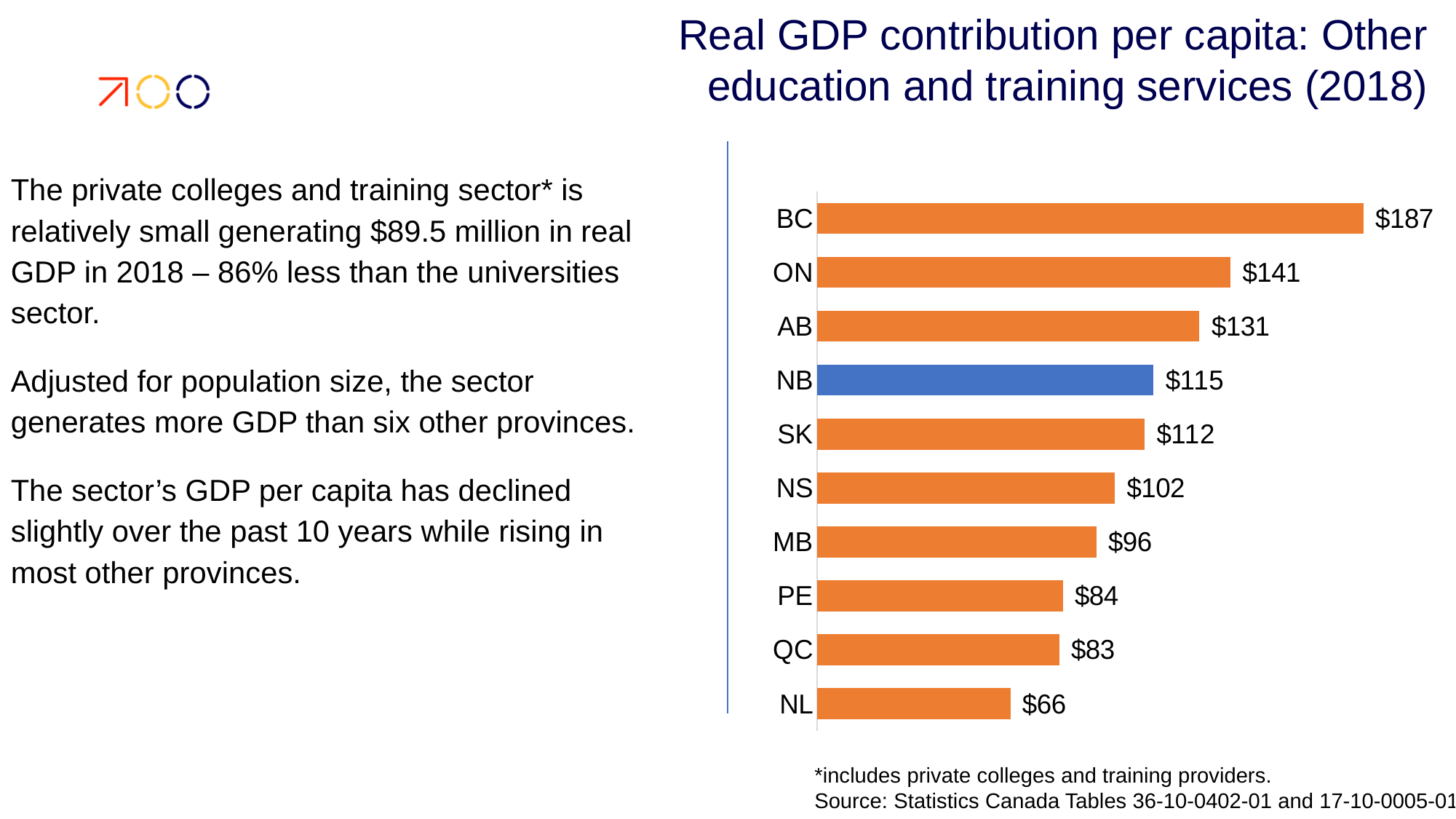
What is the difference between the values for NB and NL? $49 What is the difference between the values for BC and ON? $46 What is the real GDP contribution per capita for NB? $115 What kind of chart is shown on the slide? Bar chart What is the real GDP contribution per capita for QC? $83 Which province has the lowest real GDP contribution per capita? NL Which has a larger value, AB or SK? AB How many provinces are shown in the chart? 10 Which has a larger value, MB or NS? NS Which province has the highest real GDP contribution per capita? BC What is the real GDP contribution per capita for BC? $187 Which province's bar is coloured blue instead of orange? NB